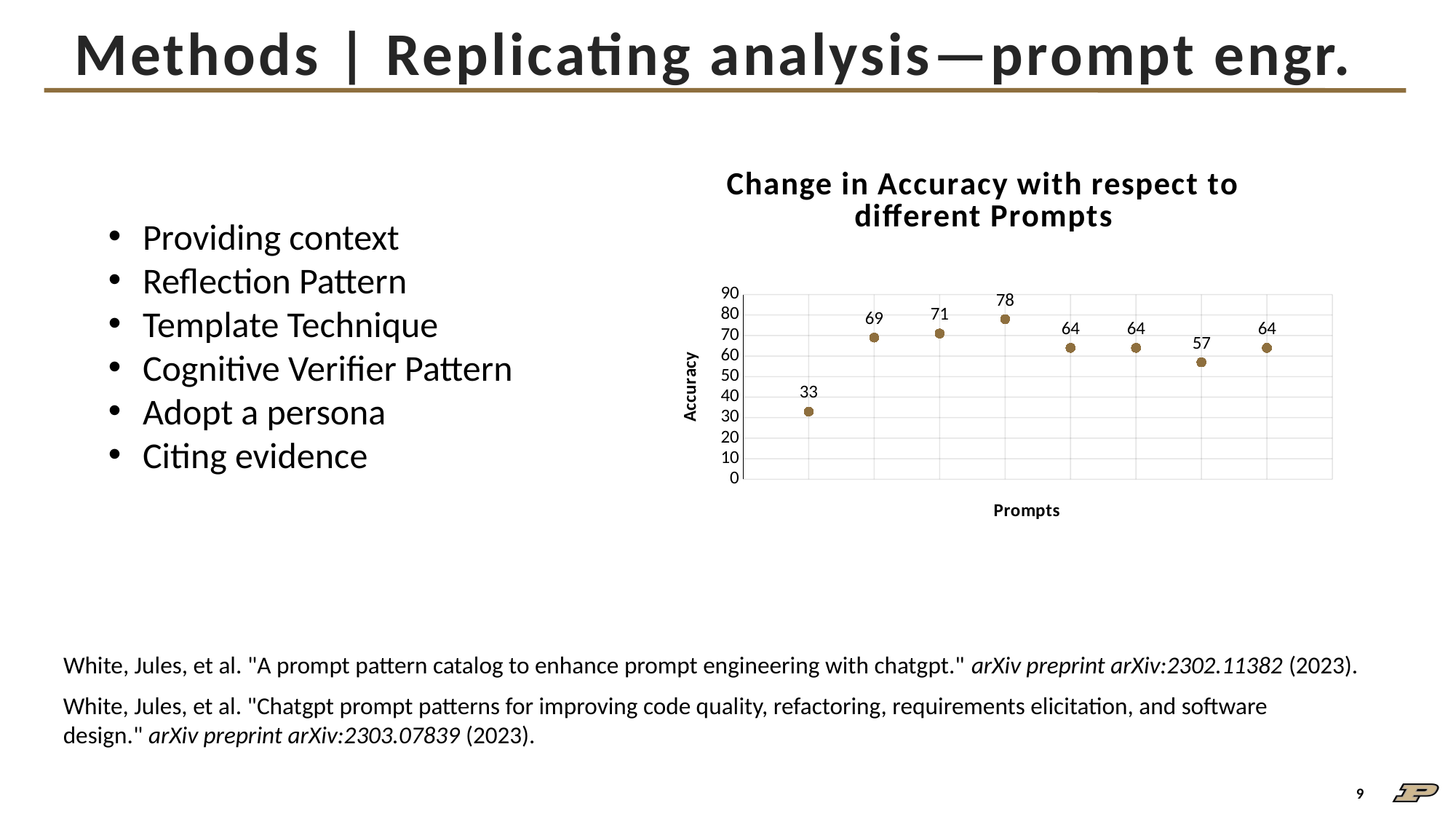
What is the lowest accuracy value plotted in the chart? 33 What is the label of the vertical axis in the chart? Accuracy How many points in the chart have an accuracy value of 64? 3 How many data points are plotted in the chart? 8 What is the accuracy value of the third point from the left in the chart? 71 What kind of chart is shown on the slide? scatter chart What is the difference between the highest accuracy value (78) and the lowest accuracy value (33) in the chart? 45 What is the title of the chart? Change in Accuracy with respect to different Prompts What is the accuracy value of the seventh point from the left in the chart? 57 What is the accuracy value of the first (leftmost) point in the chart? 33 What is the highest accuracy value plotted in the chart? 78 Which is larger: the accuracy of the second point (69) or the third point (71)? the third point (71)